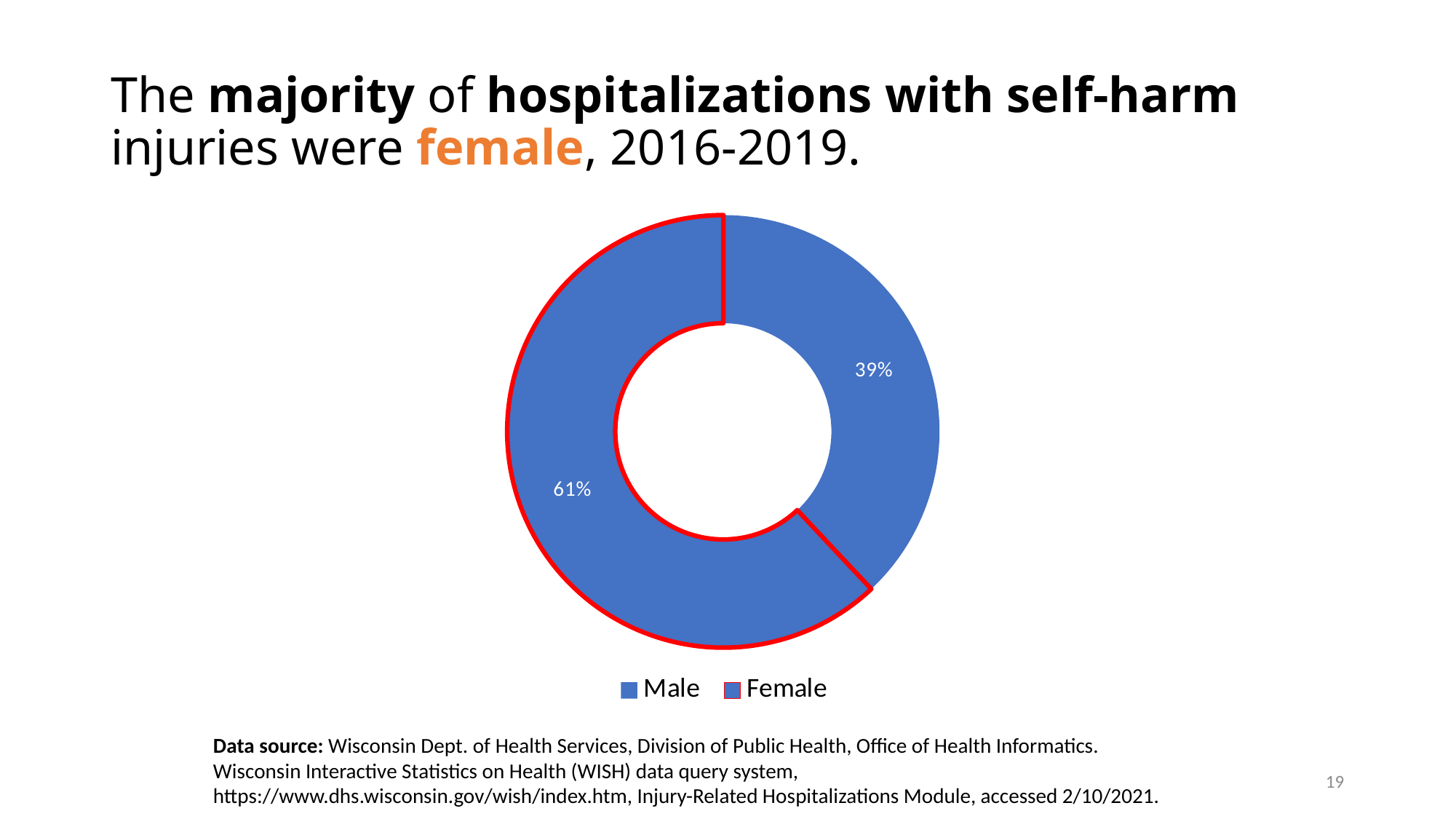
What percentage of hospitalizations with self-harm injuries were male? 39% What is the difference in percentage points between the Female and Male shares? 22 Which category has the larger share of the chart, Male or Female? Female What are the two categories listed in the legend? Male and Female What percentage of hospitalizations with self-harm injuries were female? 61% What kind of chart is shown on the slide? Doughnut chart Which category has the smallest share of the chart? Male How many entries does the legend list? 2 Which slice of the chart is outlined in red? Female Is the Male share greater or less than 50%? less Which category has the largest share of the chart? Female How many categories does the chart show? 2